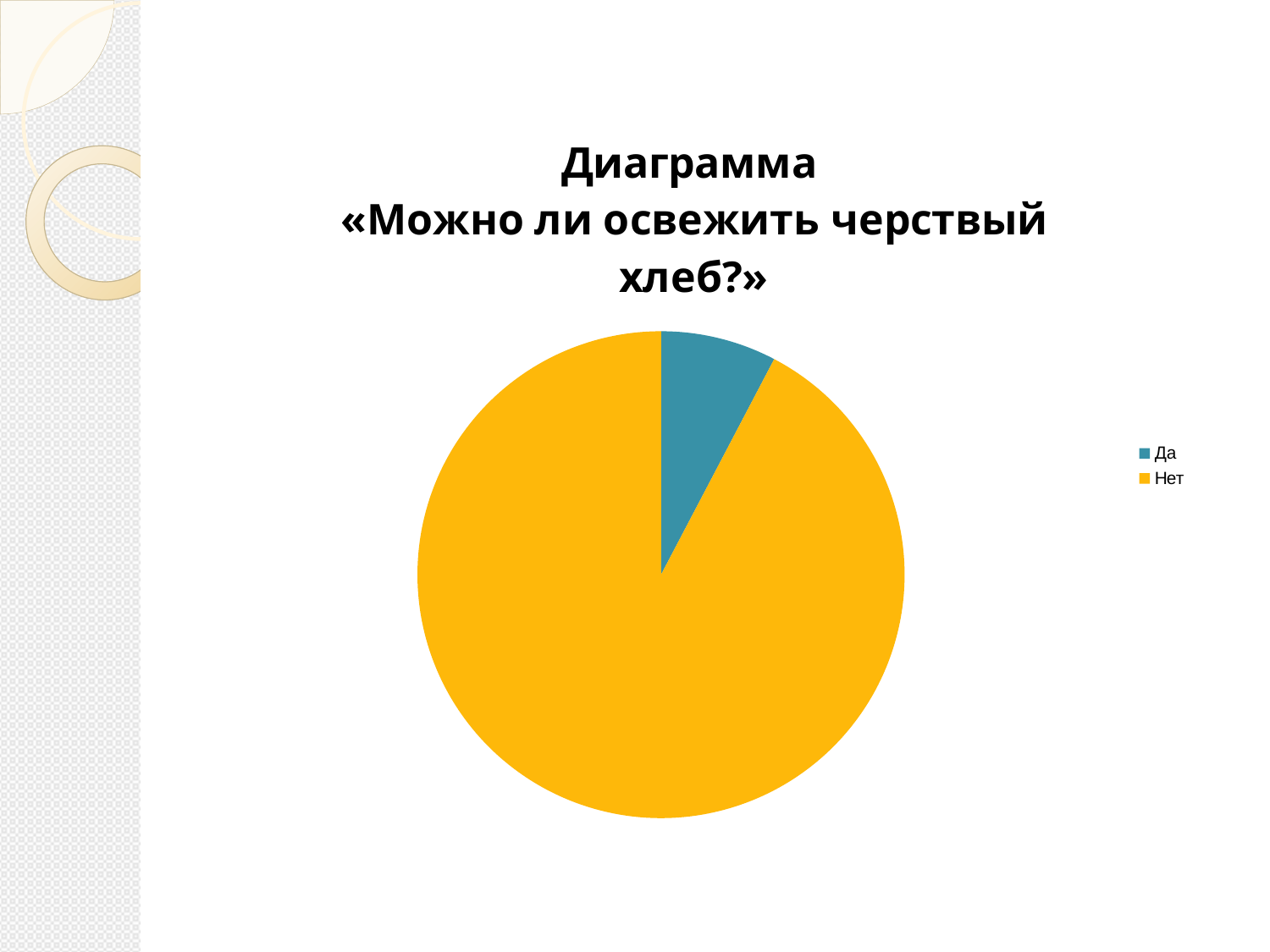
Which slice is the smallest in the pie chart? Да What colour is the slice for Нет? yellow What is the title of the chart? Диаграмма «Можно ли освежить черствый хлеб?» Which slice is the largest in the pie chart? Нет What kind of chart is shown on the slide? pie chart Which is larger, the slice for Да or the slice for Нет? Нет How many entries does the legend list? 2 How many slices does the pie chart have? 2